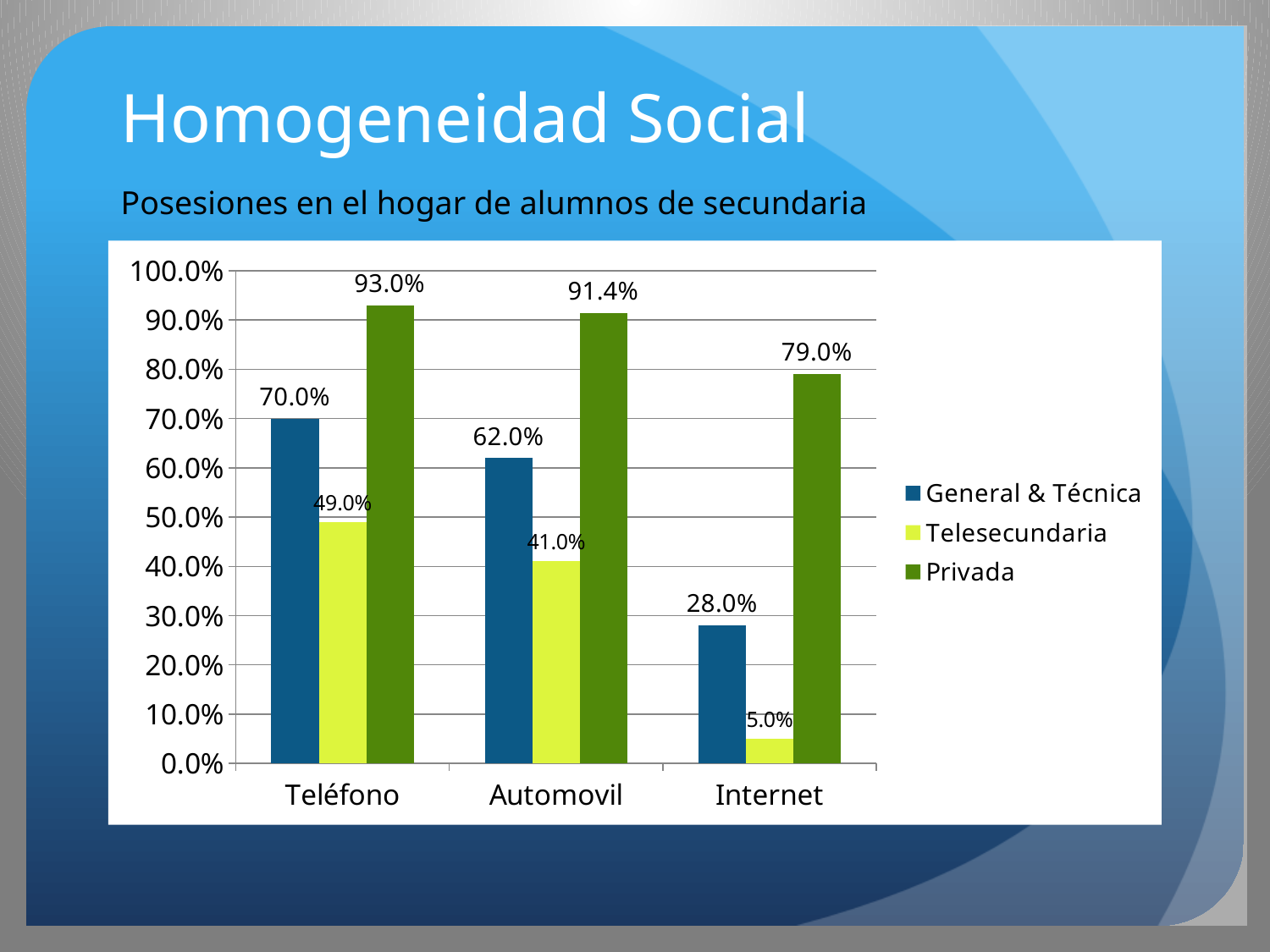
Which category has the lowest value for the Telesecundaria series? Internet What is the value for Privada in the Teléfono category? 93.0% What is the value for General & Técnica in the Automovil category? 62.0% What kind of chart is shown on the slide? Bar chart What is the difference between the Privada and General & Técnica values in the Internet category? 51.0% Which series is shown in dark green in the legend? Privada How many series does the legend list? 3 What is the value for Telesecundaria in the Internet category? 5.0% Is the value for Privada in the Automovil category greater or less than 90.0%? greater How many categories are shown on the x axis? 3 Which category has the highest value for the Privada series? Teléfono Which is larger in the Automovil category: General & Técnica or Telesecundaria? General & Técnica